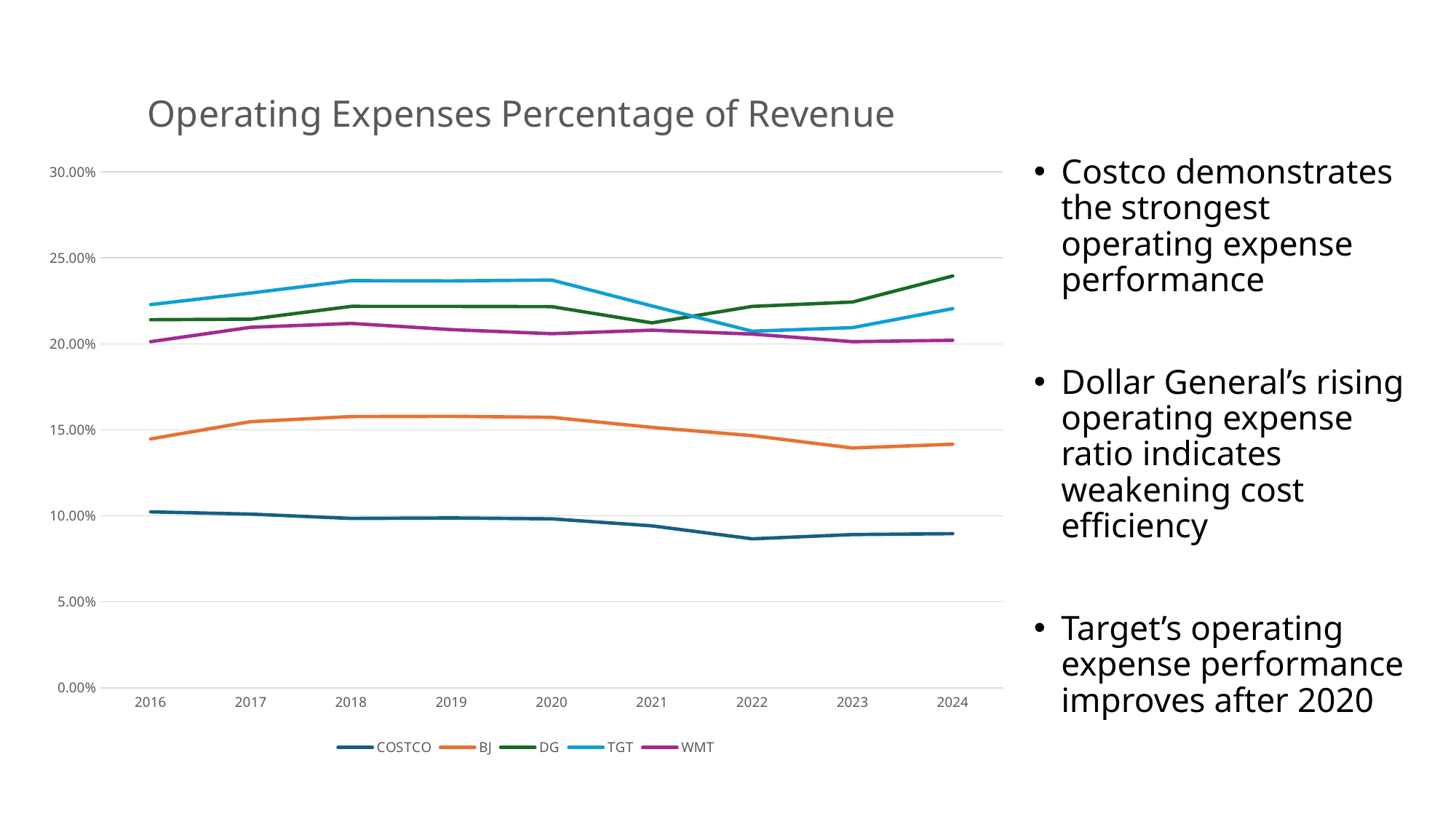
Which series has the highest value in 2020? TGT How many years are plotted along the x axis? 9 Which series has the highest value in 2024? DG What kind of chart is shown on the slide? line chart Is the value for DG in 2024 greater or less than 20.00%? greater Does the COSTCO line rise or fall from 2016 to 2022? fall In 2018, which is larger, the value for TGT or the value for WMT? TGT How many series does the legend list? 5 What is the title of the chart? Operating Expenses Percentage of Revenue Is the value for COSTCO in 2016 greater or less than 15.00%? less Which series has the lowest value in 2016? COSTCO Is the value for BJ in 2023 greater or less than 15.00%? less